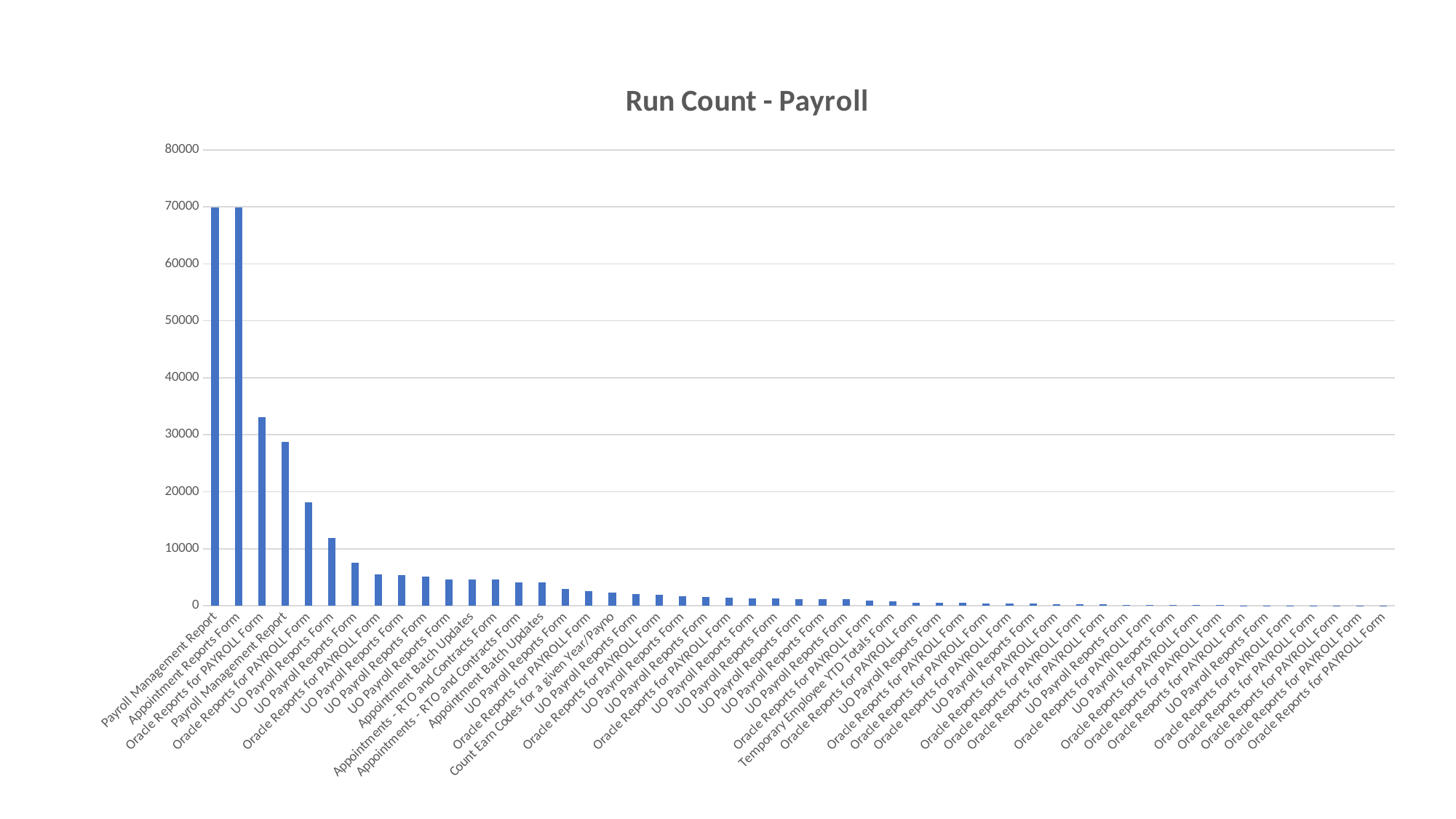
Is the value of the fifth bar from the left greater or less than 20000? less What is the highest value shown on the vertical axis? 80000 Do the bar values generally rise or fall from left to right along the x axis? fall Which has a larger value, Count Earn Codes for a given Year/Payno or Temporary Employee YTD Totals Form? Count Earn Codes for a given Year/Payno Is the value for Temporary Employee YTD Totals Form greater or less than 10000? less Is the value for Count Earn Codes for a given Year/Payno greater or less than 10000? less What kind of chart is shown on the slide? bar chart What is the title of the chart? Run Count - Payroll Which has a larger value, Appointment Reports Form or Count Earn Codes for a given Year/Payno? Appointment Reports Form